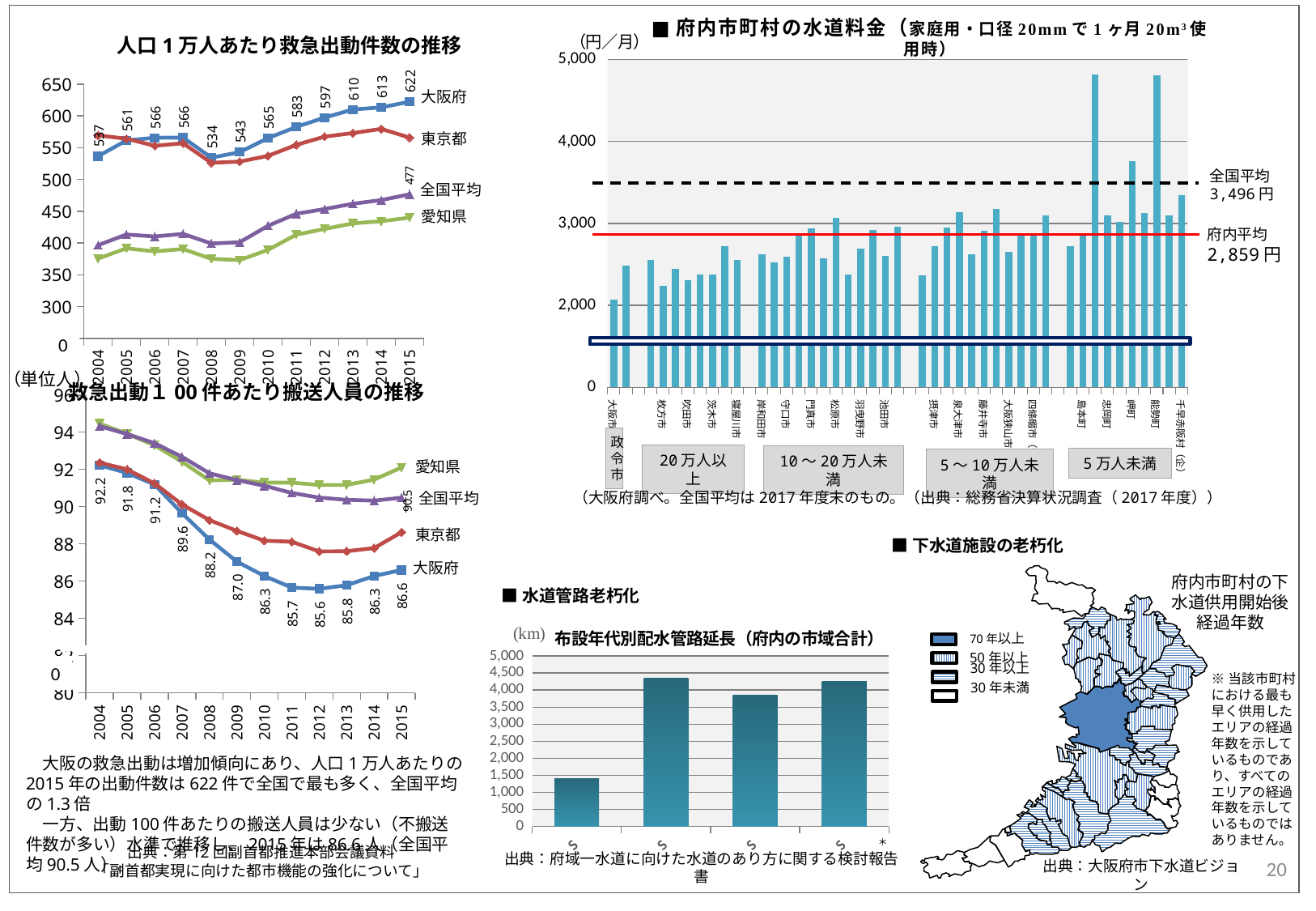
In the chart titled 人口1万人あたり救急出動件数の推移, how many series does the chart show? 4 In the chart titled 救急出動100件あたり搬送人員の推移, in which year is the 大阪府 value lowest? 2012 In the chart titled 救急出動100件あたり搬送人員の推移, what is the value for 大阪府 in 2015? 86.6 In the chart titled 府内市町村の水道料金, is the value for 大阪市 greater or less than 3,000? less In the chart titled 人口1万人あたり救急出動件数の推移, what is the value for 大阪府 in 2004? 537 In the chart titled 人口1万人あたり救急出動件数の推移, which series has the higher value in 2015, 大阪府 or 東京都? 大阪府 In the chart titled 府内市町村の水道料金, what value is shown for 全国平均? 3,496円 In the chart titled 救急出動100件あたり搬送人員の推移, what is the value for 全国平均 in 2015? 90.5 What kind of chart is 人口1万人あたり救急出動件数の推移? line chart In the chart titled 人口1万人あたり救急出動件数の推移, what is the value for 大阪府 in 2015? 622 In the chart titled 布設年代別配水管路延長（府内の市域合計）, how many bars are plotted? 4 In the chart titled 人口1万人あたり救急出動件数の推移, by how much did the 大阪府 value increase from 2004 to 2015? 85